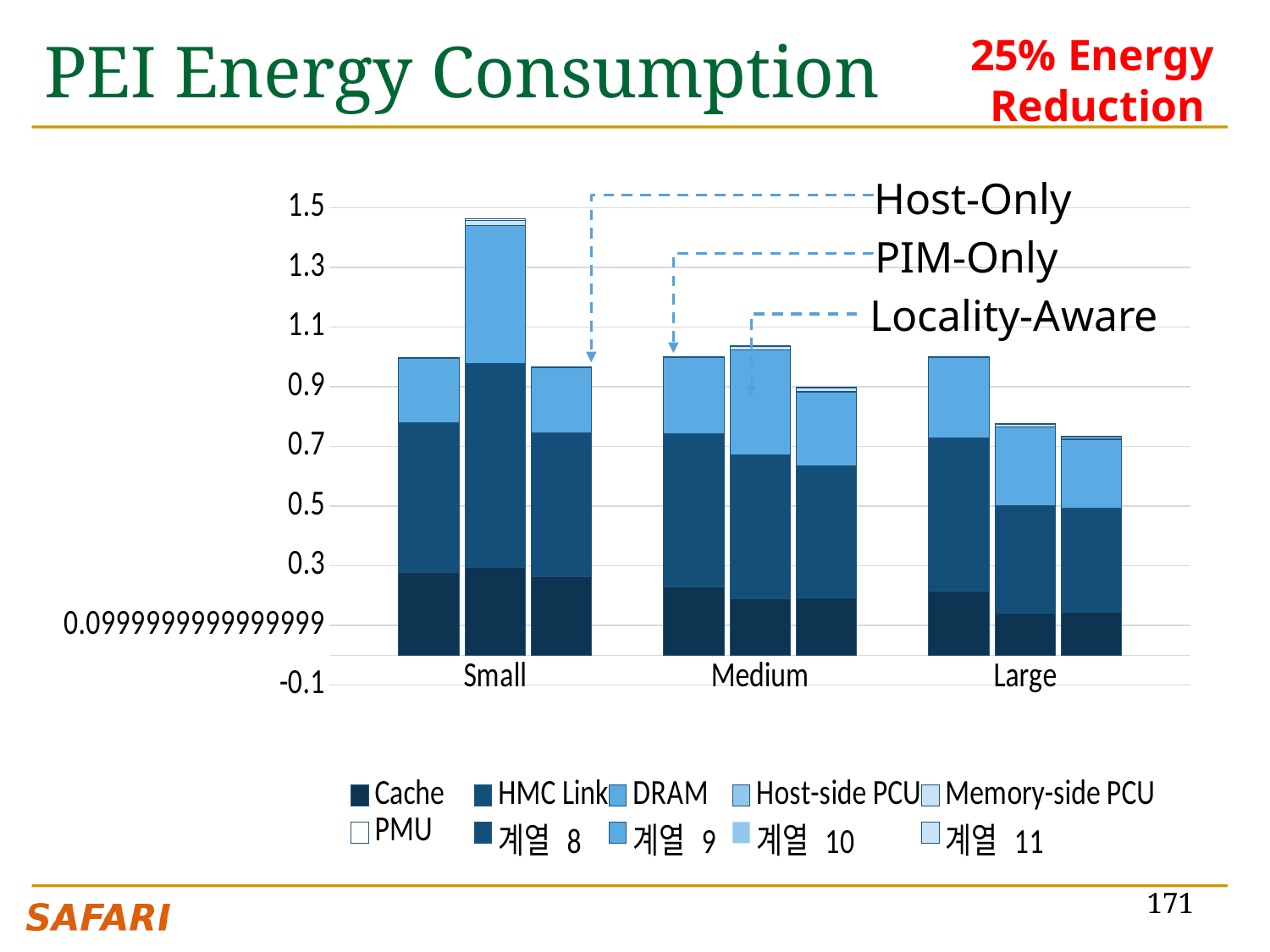
For the Large category, which bar is taller: Host-Only or PIM-Only? Host-Only Is the total of the PIM-Only bar for Medium greater or less than 0.9? greater How many categories are shown on the x axis of the chart? 3 What kind of chart is shown on the slide? Stacked bar chart For the Small category, which bar is taller: Host-Only or PIM-Only? PIM-Only Is the total of the PIM-Only bar for Large greater or less than 0.9? less Which category contains the tallest bar in the chart? Small Is the total of the Locality-Aware bar for Large greater or less than 0.9? less What is the title of the chart on the slide? PEI Energy Consumption How many series does the chart's legend list? 10 Which three bar configurations are labelled by the dashed arrows in the chart? Host-Only, PIM-Only, Locality-Aware